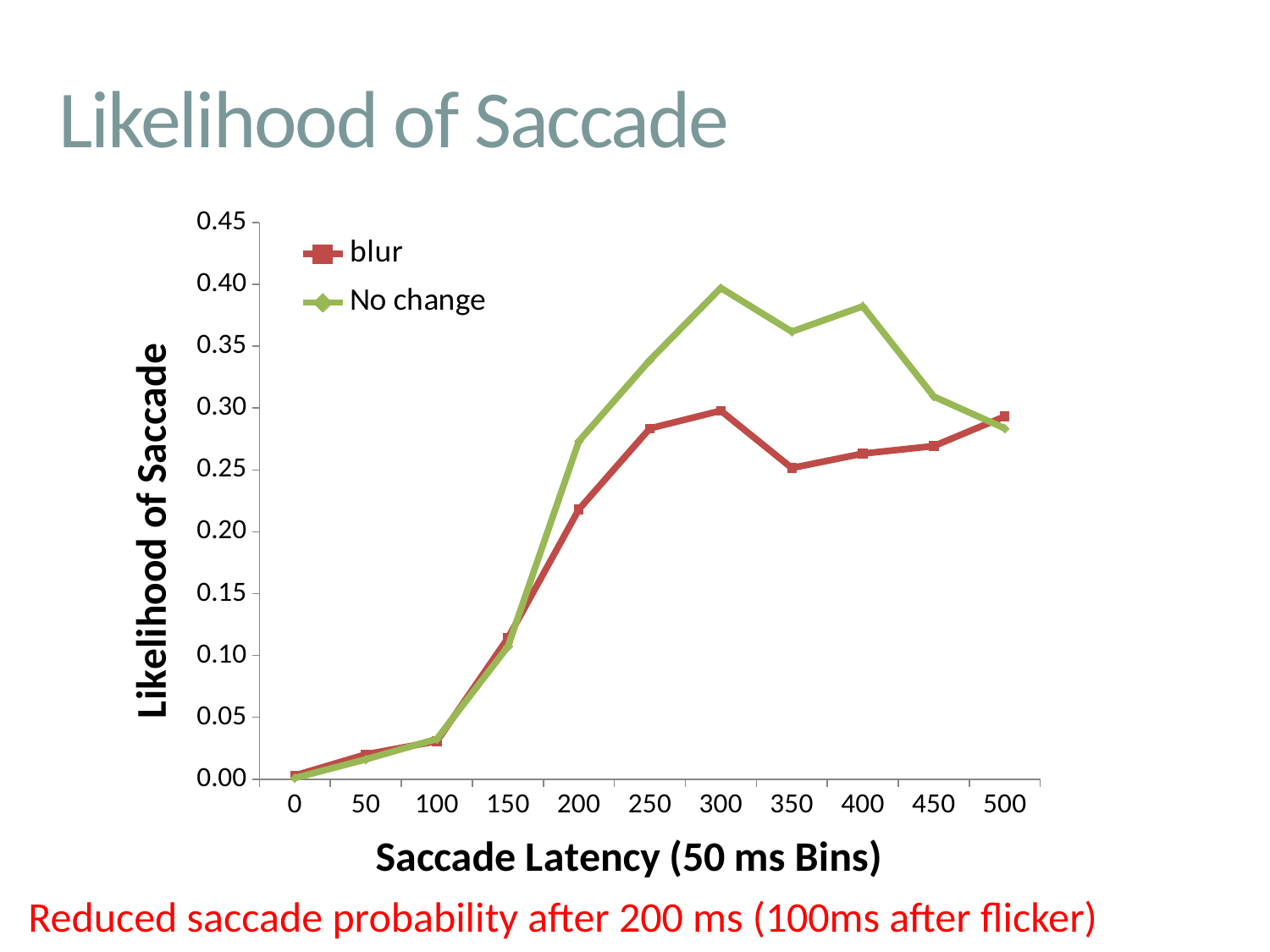
Does the blur series rise or fall between saccade latencies of 0 and 300? rise How many saccade latency bins are plotted along the x axis? 11 What kind of chart is shown on the slide? line chart Does the No change series rise or fall between saccade latencies of 400 and 500? fall What is the title of the x axis? Saccade Latency (50 ms Bins) Is the value for blur at a saccade latency of 150 greater or less than 0.15? less At a saccade latency of 300, which series has the larger value, blur or No change? No change How many series does the legend list? 2 At which saccade latency does the No change series reach its highest value? 300 Is the value for blur at a saccade latency of 350 greater or less than 0.30? less At a saccade latency of 400, which series has the larger value, blur or No change? No change Is the value for No change at a saccade latency of 300 greater or less than 0.35? greater